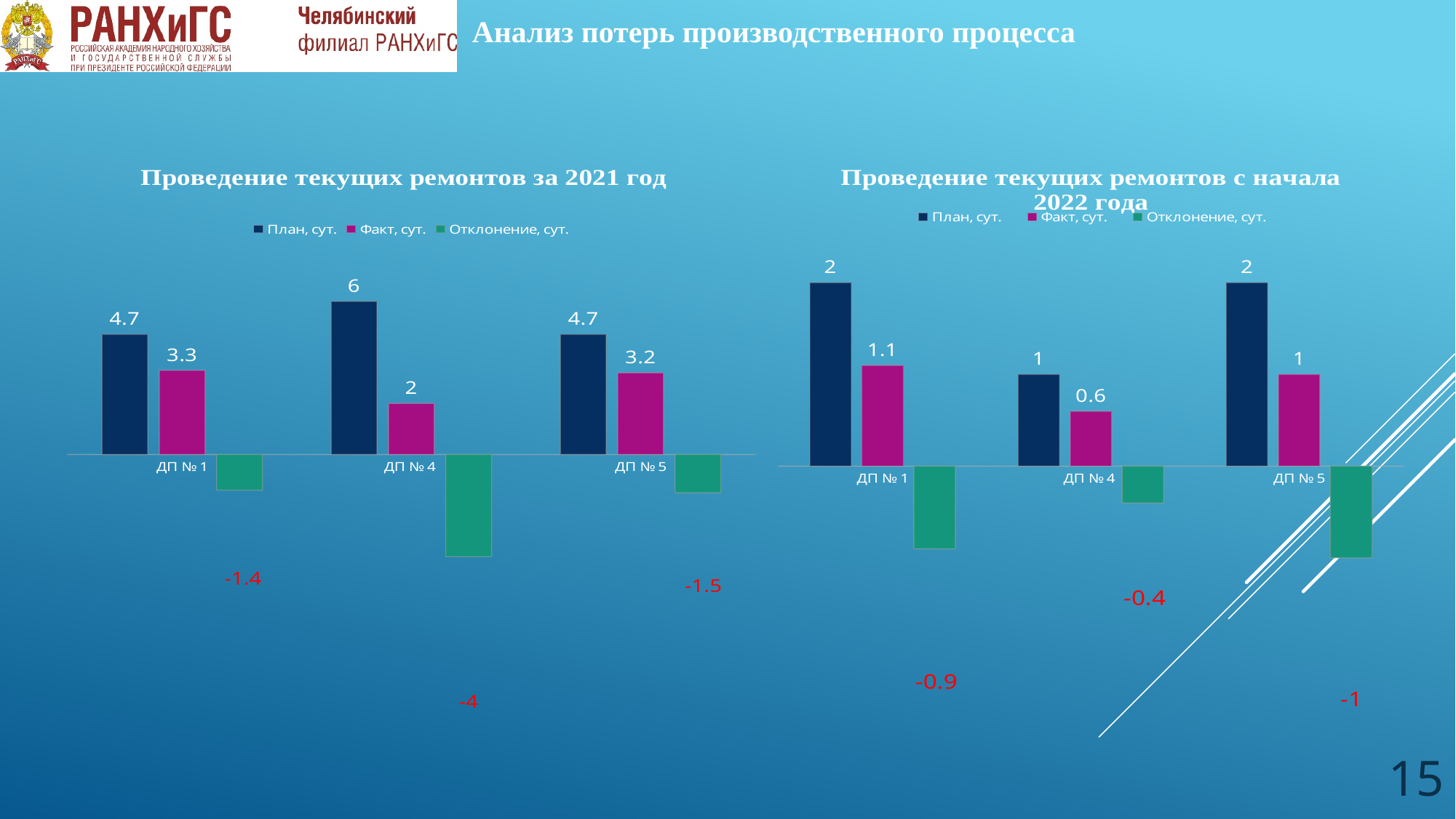
On the chart 'Проведение текущих ремонтов за 2021 год', which category has the lowest 'Факт, сут.' value? ДП № 4 On the chart 'Проведение текущих ремонтов за 2021 год', what is the value of 'Отклонение, сут.' for ДП № 4? -4 On the chart 'Проведение текущих ремонтов с начала 2022 года', what is the value of 'Факт, сут.' for ДП № 4? 0.6 On the chart 'Проведение текущих ремонтов за 2021 год', what is the value of 'План, сут.' for ДП № 4? 6 On the chart 'Проведение текущих ремонтов за 2021 год', how many series does the legend list? 3 On the chart 'Проведение текущих ремонтов за 2021 год', which category has the highest 'План, сут.' value? ДП № 4 On the chart 'Проведение текущих ремонтов за 2021 год', what is the difference between 'План, сут.' and 'Факт, сут.' for ДП № 1? 1.4 On the chart 'Проведение текущих ремонтов с начала 2022 года', what is the value of 'Отклонение, сут.' for ДП № 1? -0.9 On the chart 'Проведение текущих ремонтов с начала 2022 года', how many categories are shown on the x axis? 3 What type of chart is 'Проведение текущих ремонтов с начала 2022 года'? Bar chart On the chart 'Проведение текущих ремонтов за 2021 год', what is the value of 'Факт, сут.' for ДП № 5? 3.2 On the chart 'Проведение текущих ремонтов с начала 2022 года', which is larger: 'Факт, сут.' for ДП № 1 or for ДП № 5? ДП № 1